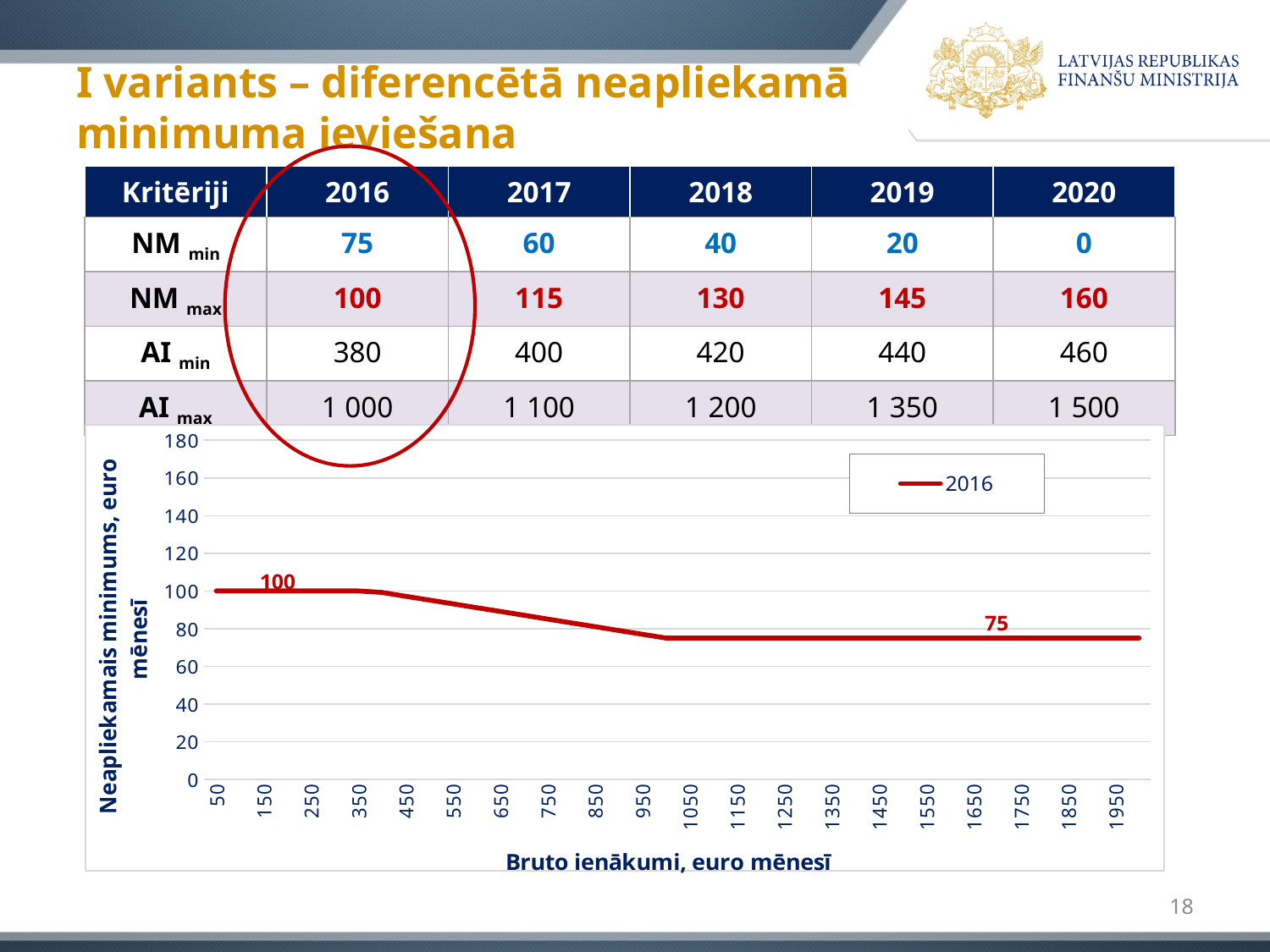
How many series does the chart legend list? 1 Does the 2016 line rise or fall as gross income increases along the x axis? fall What kind of chart is shown on the slide? line chart Is the value of the 2016 line at a gross income of 1950 greater or less than 80? less What is the highest value labelled on the 2016 line? 100 How many tick labels are shown on the chart's x axis? 20 What series name appears in the chart legend? 2016 What is the lowest value labelled on the 2016 line? 75 What is the title of the chart's x axis? Bruto ienākumi, euro mēnesī Which is larger on the 2016 line: the value at a gross income of 150 or the value at a gross income of 1650? 150 What is the difference between the two labelled values on the 2016 line, 100 and 75? 25 Is the value of the 2016 line at a gross income of 250 greater or less than 80? greater